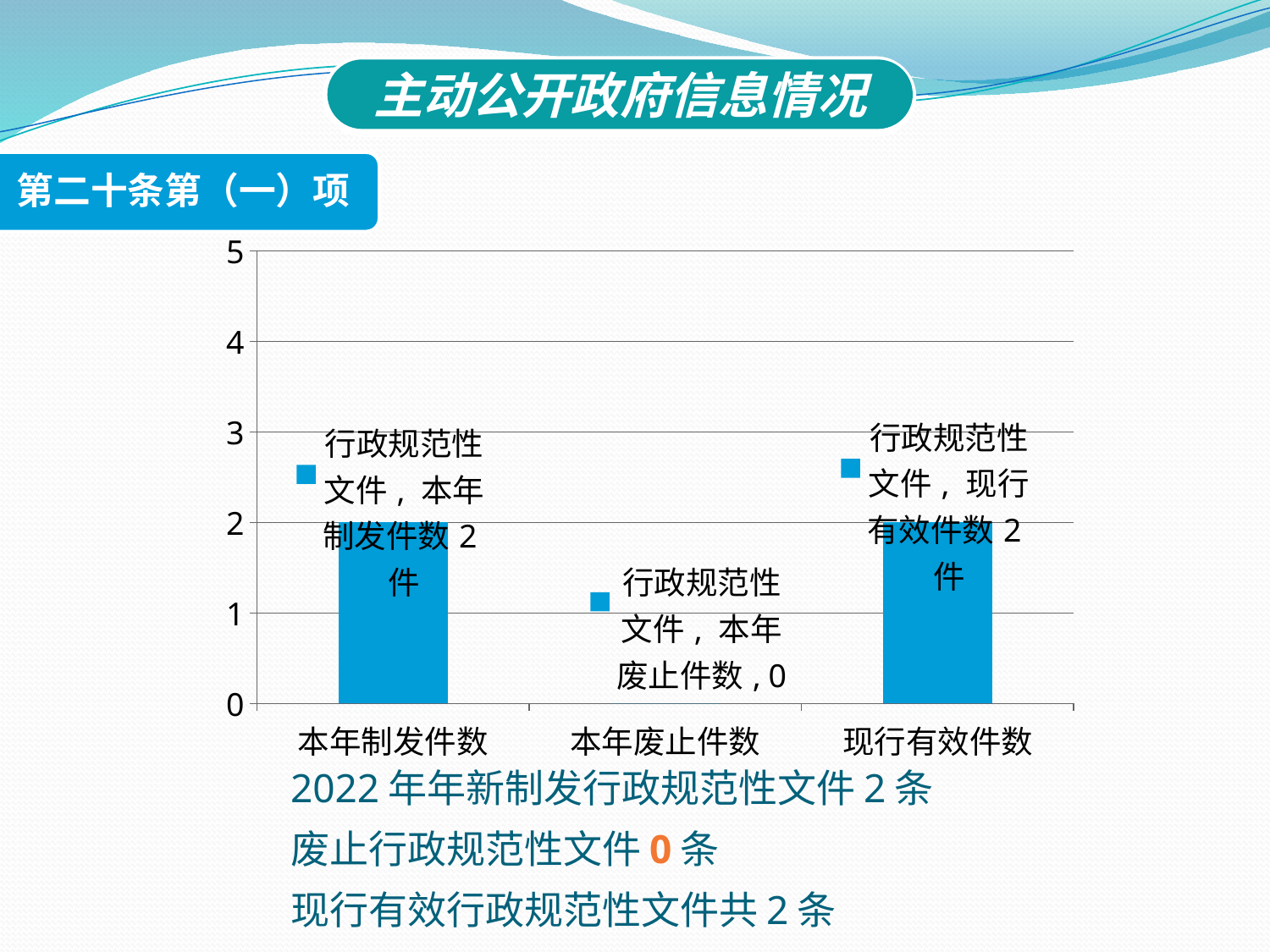
What is the title shown at the top of the slide? 主动公开政府信息情况 Is the value for 现行有效件数 greater or less than 1? greater Which is larger, the value for 现行有效件数 or the value for 本年废止件数? 现行有效件数 What kind of chart is shown on the slide? bar chart Is the value for 本年制发件数 greater or less than 3? less What is the value for 本年制发件数? 2 What is the value for 本年废止件数? 0 What is the highest value shown on the vertical axis of the chart? 5 What is the value for 现行有效件数? 2 Which category has the lowest value? 本年废止件数 How many categories are shown on the x axis of the chart? 3 What is the difference between the values for 本年制发件数 and 本年废止件数? 2